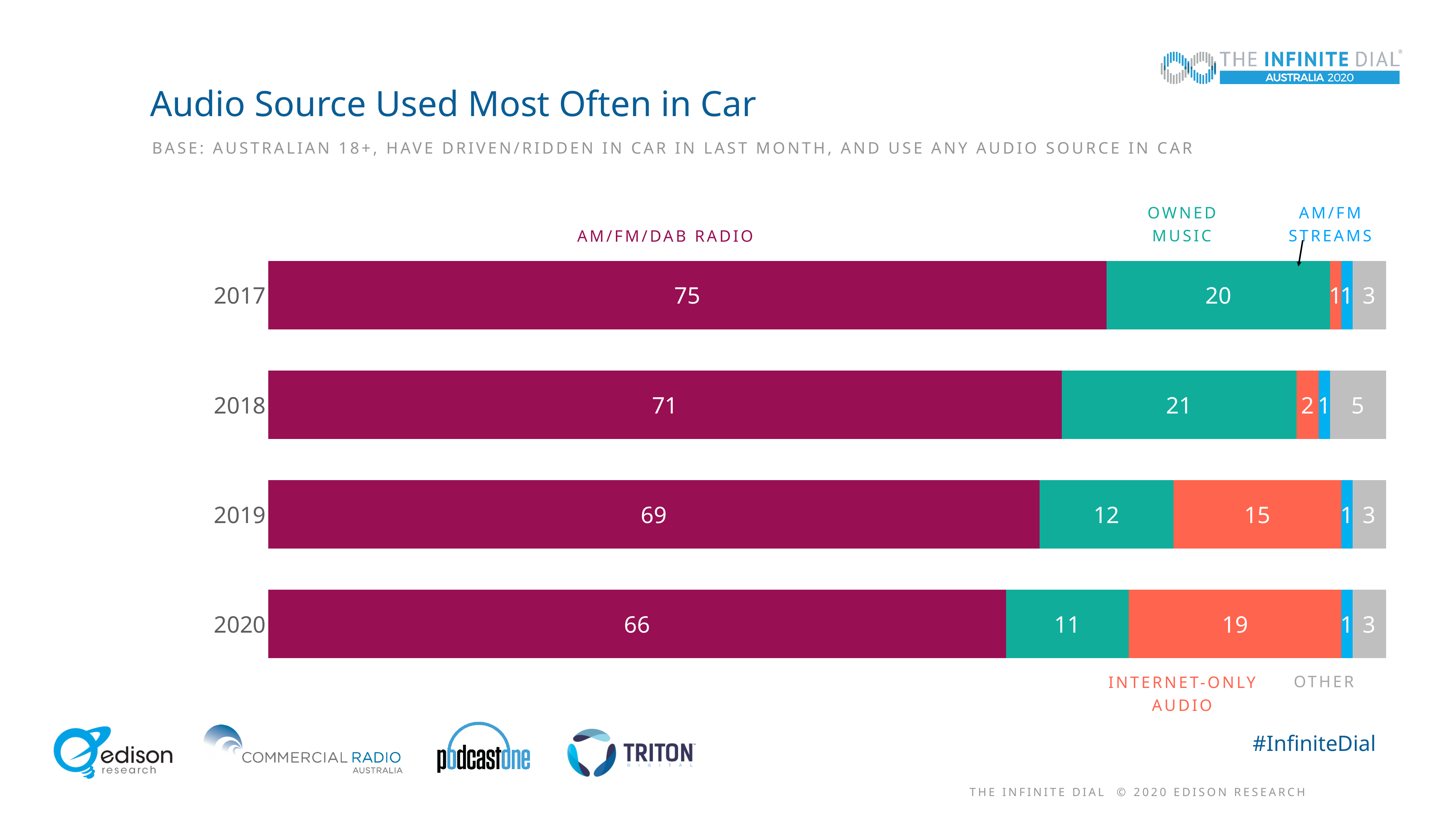
What kind of chart is shown on the slide? Stacked bar chart How many years are shown on the chart? 4 Does the AM/FM/DAB Radio value rise or fall from 2017 to 2020? Fall What is the value for Internet-Only Audio in 2019? 15 How many audio source categories are labelled on the chart? 5 What is the value for Other in 2018? 5 In which year is the Owned Music value lowest? 2020 What is the value for Owned Music in 2018? 21 What is the difference between the AM/FM/DAB Radio values for 2017 and 2020? 9 In which year is the AM/FM/DAB Radio value highest? 2017 Which is larger in 2020: Owned Music or Internet-Only Audio? Internet-Only Audio What is the value for AM/FM/DAB Radio in 2020? 66